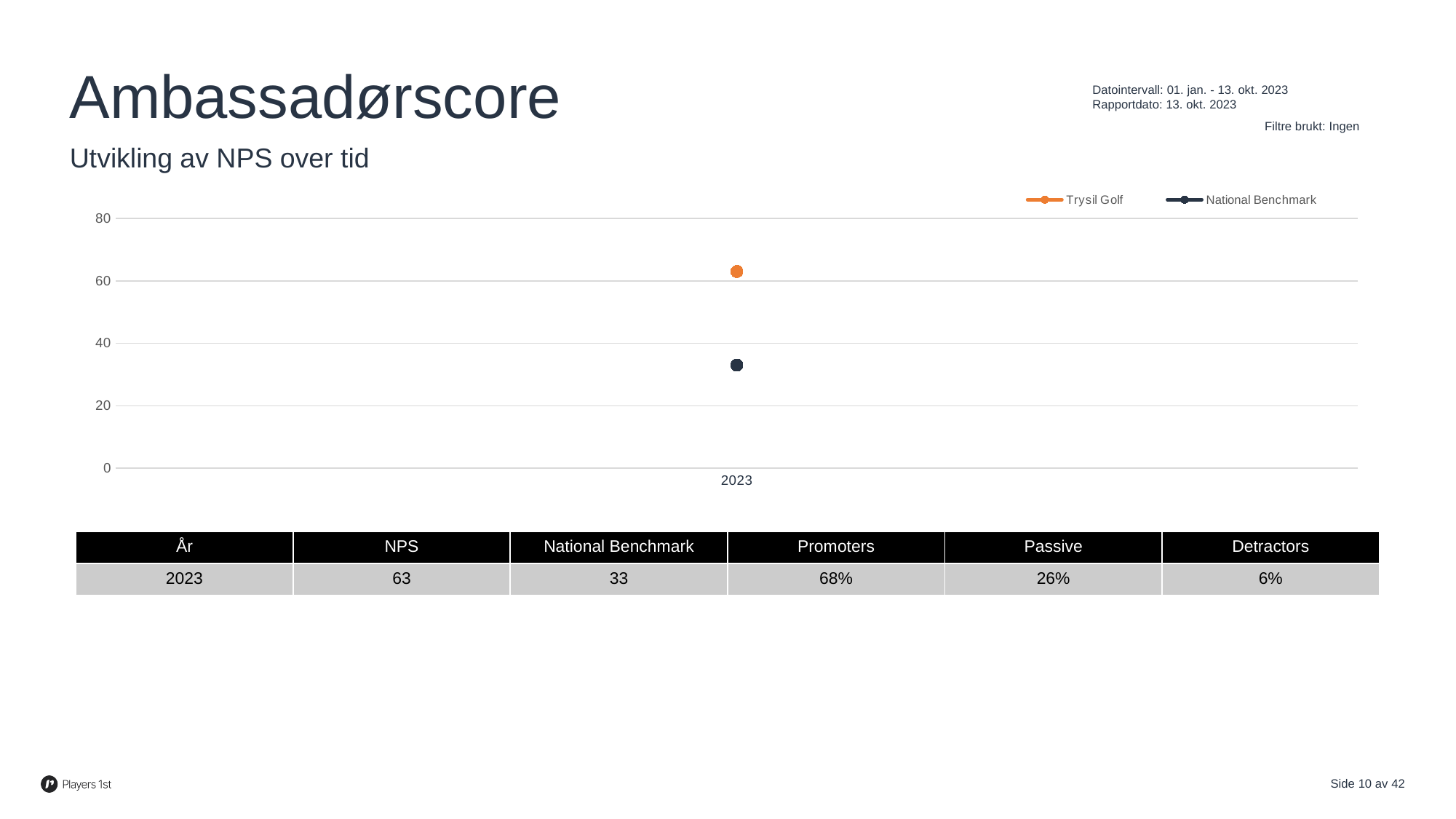
What is the highest value shown on the y axis? 80 How many series does the legend list? 2 Is the value for Trysil Golf in 2023 greater or less than 60? greater What is the value for National Benchmark in 2023? 33 What is the value for Trysil Golf in 2023? 63 What is the difference between the Trysil Golf value and the National Benchmark value in 2023? 30 Which series is shown in orange in the legend? Trysil Golf Which series has the higher value in 2023, Trysil Golf or National Benchmark? Trysil Golf What is the title of the chart? Utvikling av NPS over tid Is the value for National Benchmark in 2023 greater or less than 40? less How many years are shown on the x axis? 1 What kind of chart is shown? line chart